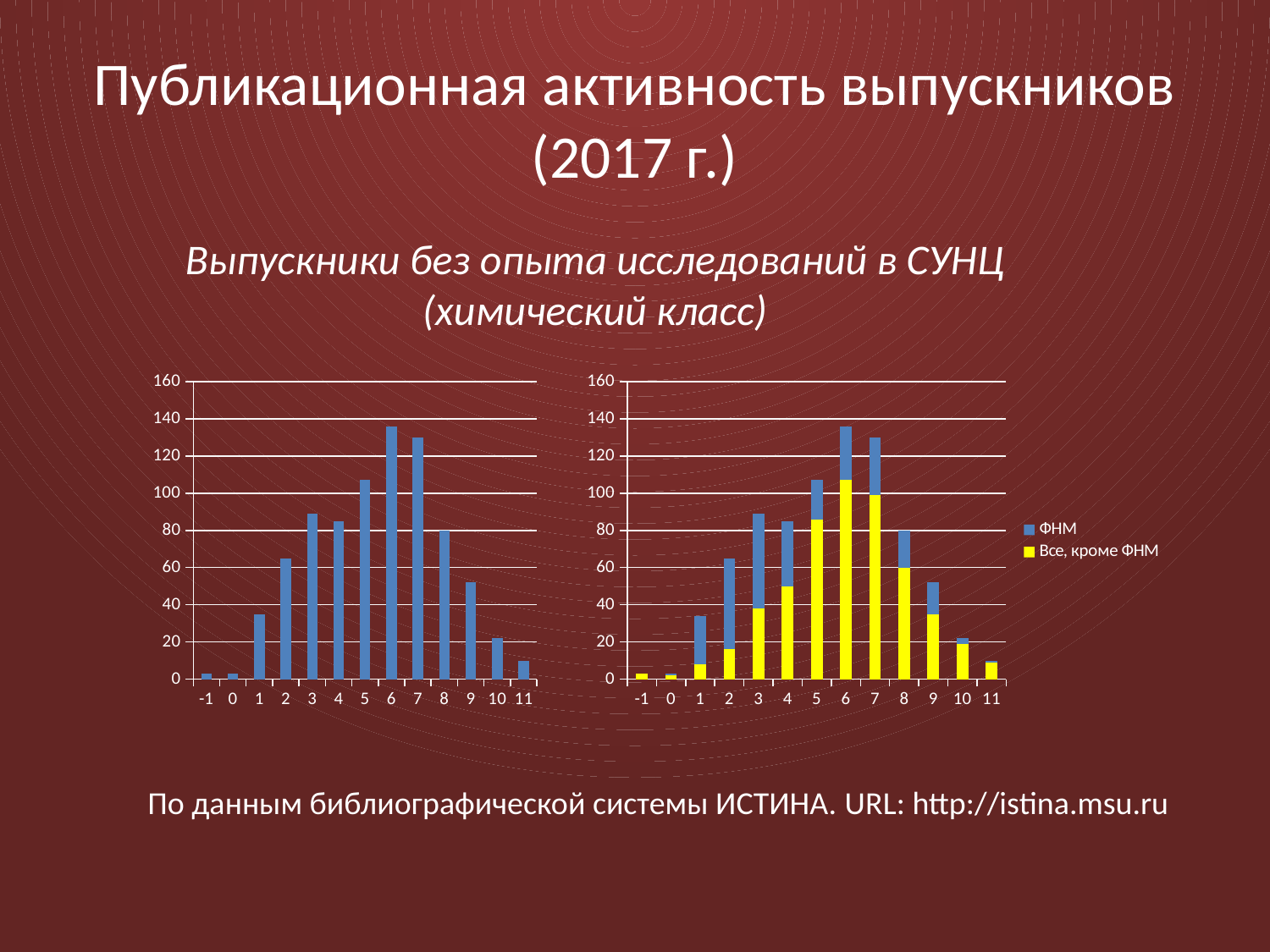
In the left chart, which is larger, the value for category 8 or the value for category 9? 8 How many series does the legend of the right chart list? 2 In the left chart, is the value for category 5 greater or less than 100? greater In the left chart, is the value for category 10 greater or less than 40? less In the left chart, is the value for category 2 greater or less than 60? greater In the left chart, which category has the highest bar? 6 How many categories are shown on the x axis of the left chart? 13 What kind of chart is the left chart on the slide? bar chart In the right chart, which colour represents the 'ФНМ' series? blue